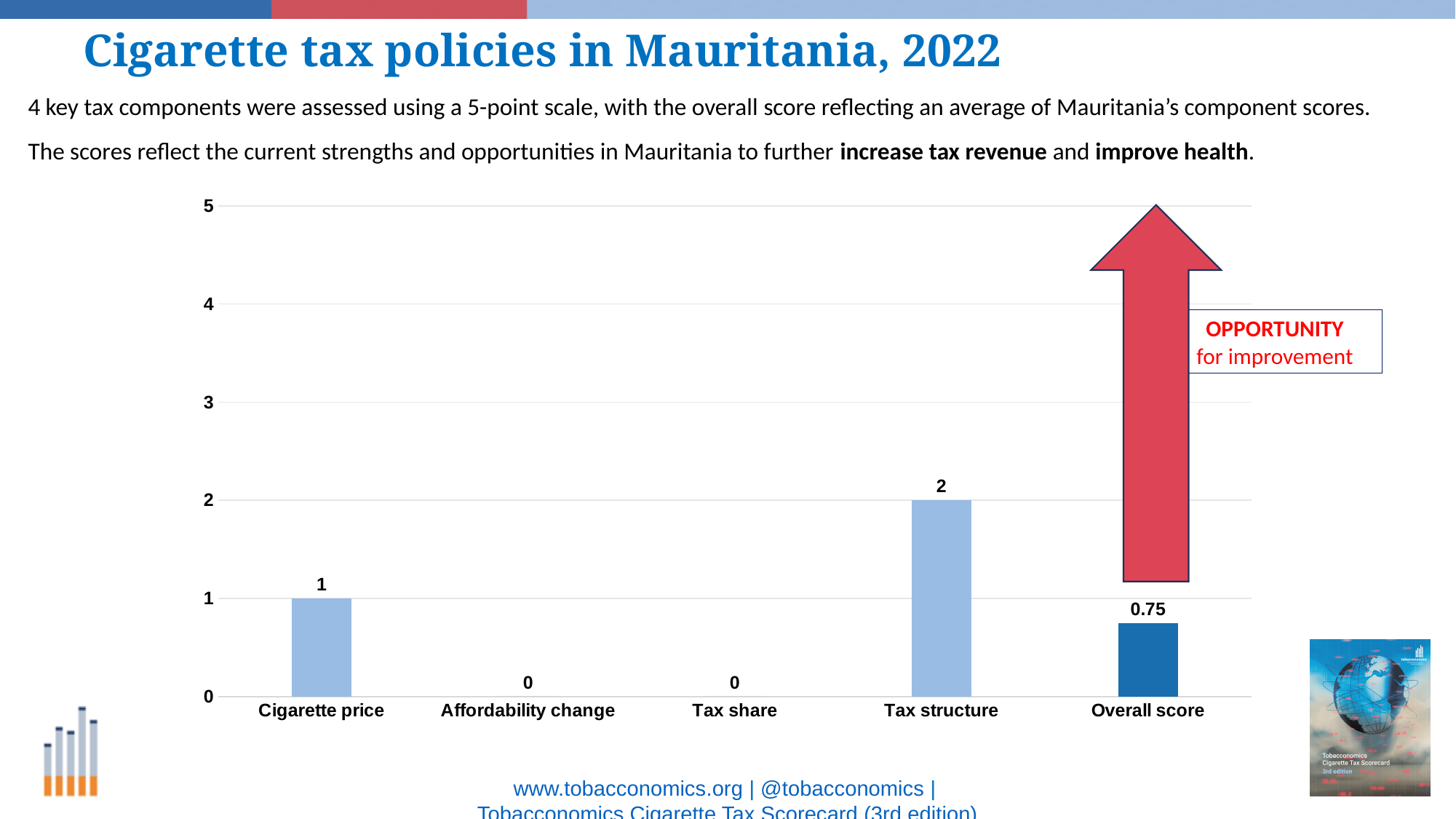
What is the difference between the values for Tax structure and Cigarette price? 1 Is the value for Tax structure greater or less than 1? greater Which is larger, the value for Cigarette price or the value for Overall score? Cigarette price What is the maximum value shown on the y axis? 5 What is the value for Affordability change? 0 Which category has the highest value? Tax structure What is the value for Tax structure? 2 What is the value for Cigarette price? 1 What kind of chart is shown on the slide? bar chart How many categories are shown on the x axis? 5 How many categories have a value of 0? 2 What is the value for Overall score? 0.75